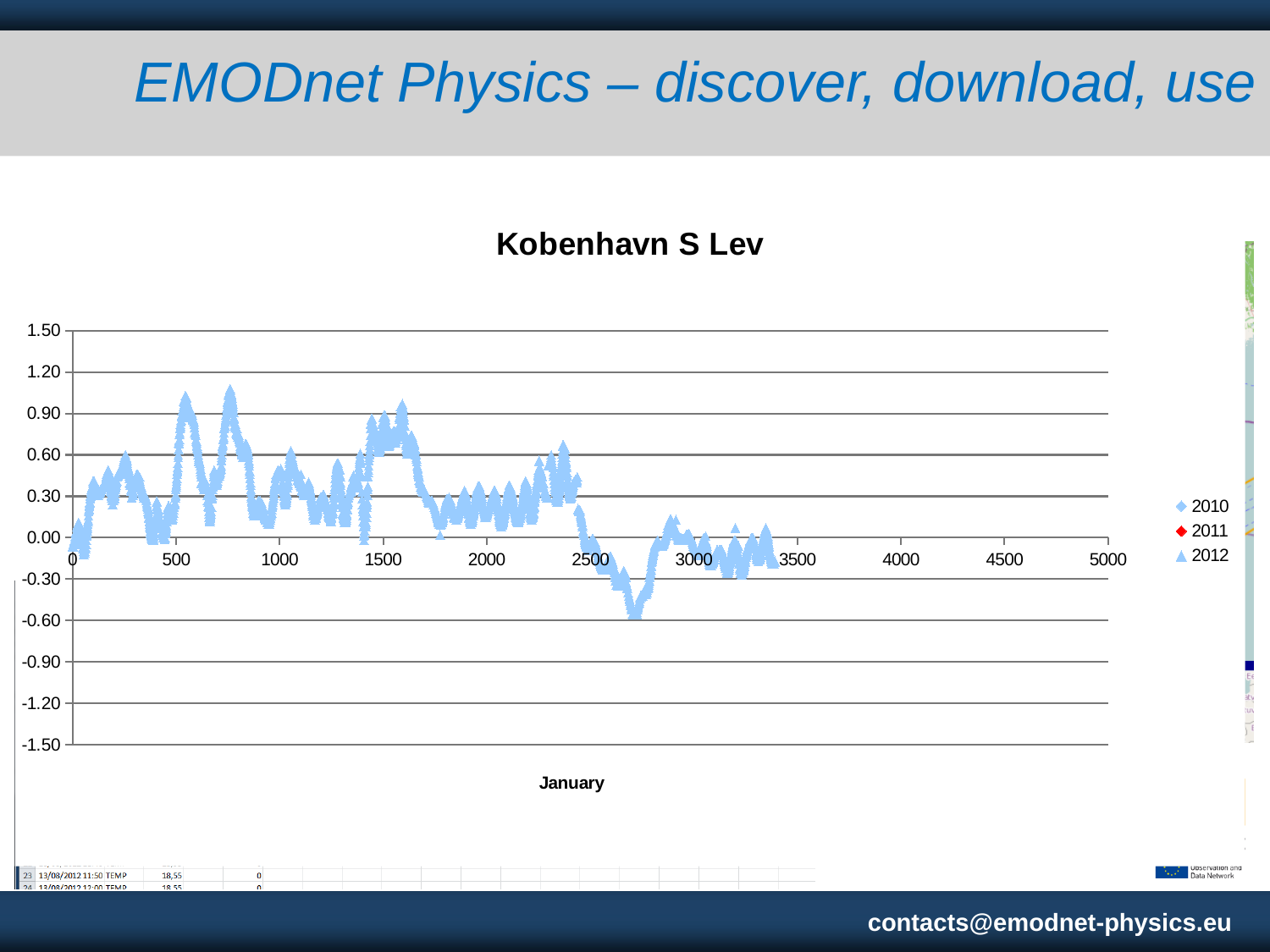
Which legend entry is shown with a red diamond marker? 2011 What is the highest tick value shown on the x axis? 5000 What is the title of the x axis of the chart? January How many series does the chart's legend list? 3 Is the highest plotted value in the chart greater or less than 0.90? greater Is the plotted value near x = 750 greater or less than 0.60? greater What kind of chart is shown on the slide? scatter chart What is the title of the chart? Kobenhavn S Lev Is the plotted value near x = 2700 greater or less than 0.00? less What is the highest tick value shown on the y axis? 1.50